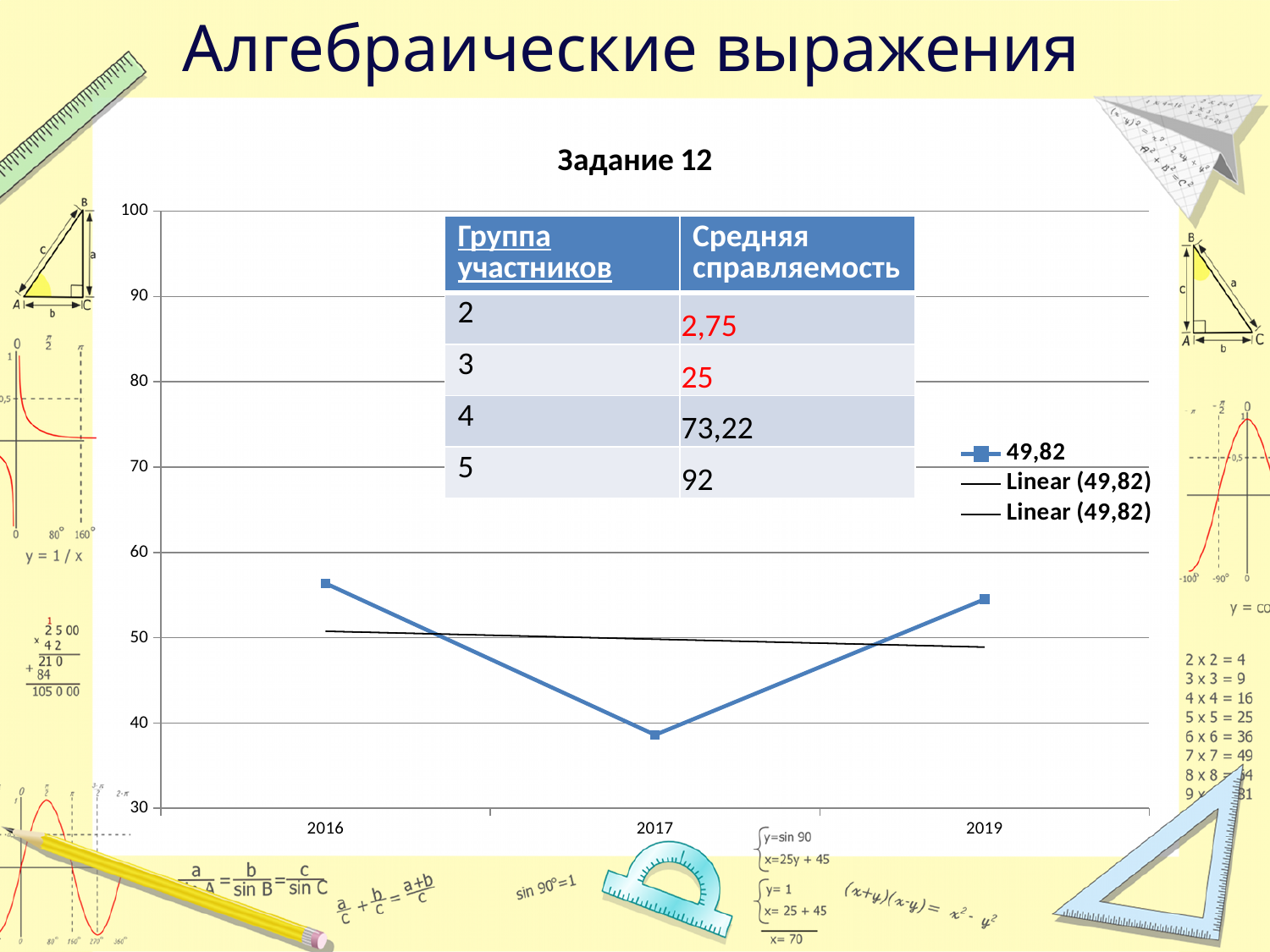
Is the value for 2017 greater or less than 40? less Which is larger, the value for 2016 or the value for 2017? 2016 What is the title of the chart? Задание 12 How many data points are plotted on the blue line? 3 Is the value for 2016 greater or less than 60? less Is the value for 2016 greater or less than 50? greater How many entries does the chart legend list? 3 What kind of chart is shown on the slide? line chart Does the blue line rise or fall from 2017 to 2019? rise Which year has the lowest value on the blue line? 2017 What is the name of the blue data series in the legend? 49,82